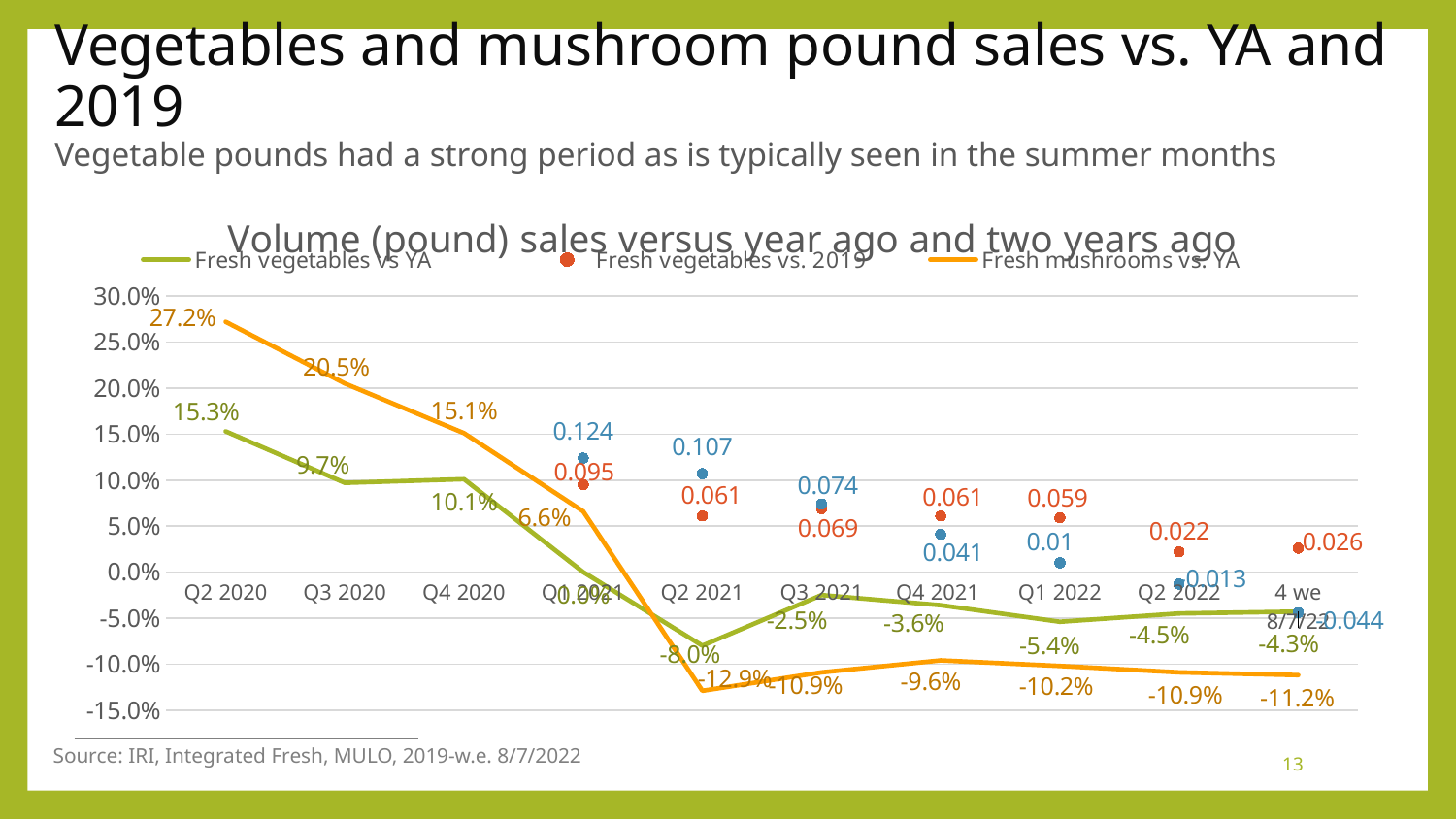
What is the difference between Fresh mushrooms vs. YA and Fresh vegetables vs YA in Q2 2020? 11.9 percentage points Does Fresh mushrooms vs. YA rise or fall from Q2 2020 to Q2 2021? Fall In which period is Fresh mushrooms vs. YA at its lowest? Q2 2021 How many periods are shown on the x axis? 10 How many series does the legend list? 3 What is the value for Fresh mushrooms vs. YA in Q2 2020? 27.2% In Q3 2020, which is larger: Fresh mushrooms vs. YA or Fresh vegetables vs YA? Fresh mushrooms vs. YA What is the value for Fresh vegetables vs YA in Q4 2020? 10.1% In which period is Fresh vegetables vs YA at its highest? Q2 2020 What is the value for Fresh vegetables vs. 2019 in Q1 2021? 0.095 What is the value for Fresh mushrooms vs. YA in Q1 2022? -10.2% What kind of chart is this? Line chart